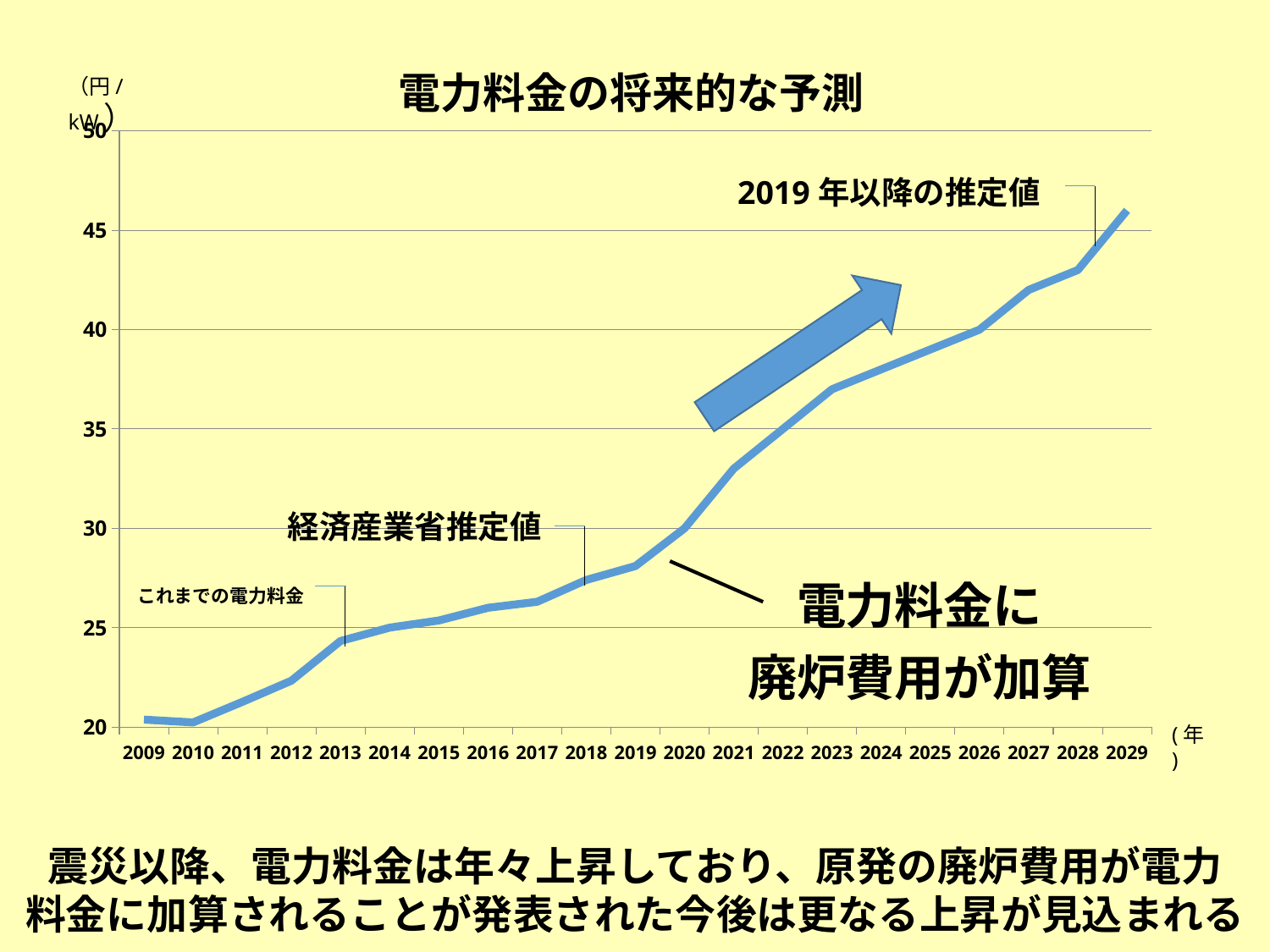
Is the value for 2016 greater or less than 25? greater Is the value for 2019 greater or less than 30? less What kind of chart is shown on the slide? line chart Is the value for 2021 greater or less than 35? less Do the values rise or fall from 2009 to 2029? rise Which year has the larger value, 2022 or 2028? 2028 Which year has the highest value on the chart? 2029 How many years are plotted along the x axis of the chart? 21 What is the title of the chart? 電力料金の将来的な予測 According to the annotation on the chart, from which year onward are the values estimates (推定値)? 2019